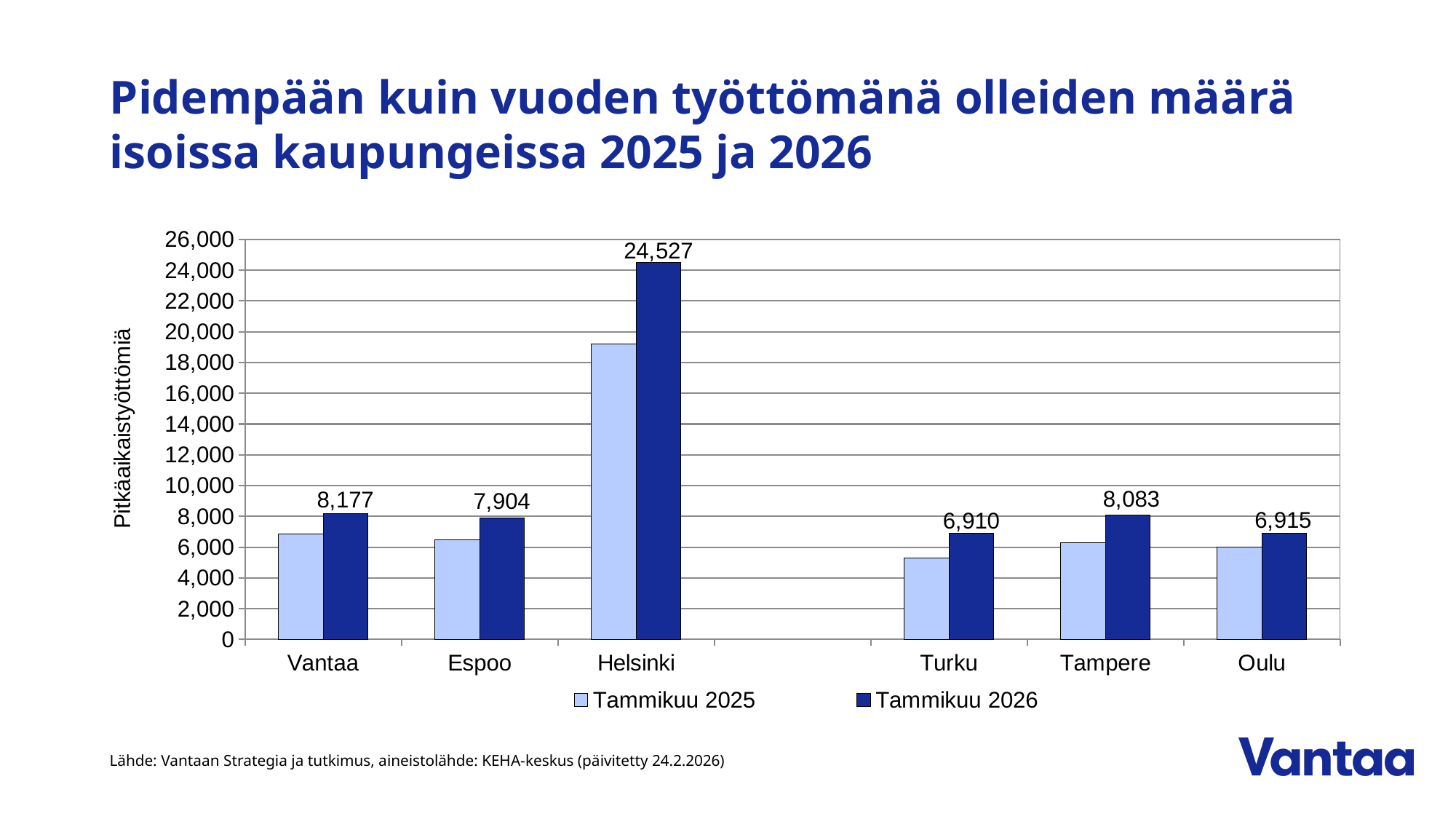
How many series does the legend list? 2 What is the value for Vantaa in the Tammikuu 2026 series? 8,177 What is the difference between the Tammikuu 2026 values for Tampere and Oulu? 1,168 What is the value for Tampere in the Tammikuu 2026 series? 8,083 What is the value for Helsinki in the Tammikuu 2026 series? 24,527 What is the difference between the Tammikuu 2026 values for Helsinki and Vantaa? 16,350 How many cities are shown on the x axis of the chart? 6 Is the Tammikuu 2025 value for Turku greater or less than 6,000? less What kind of chart is shown on the slide? bar chart Is the Tammikuu 2025 value for Helsinki greater or less than 18,000? greater Which is larger in the Tammikuu 2026 series, Tampere or Espoo? Tampere Which city has the highest value in the Tammikuu 2026 series? Helsinki